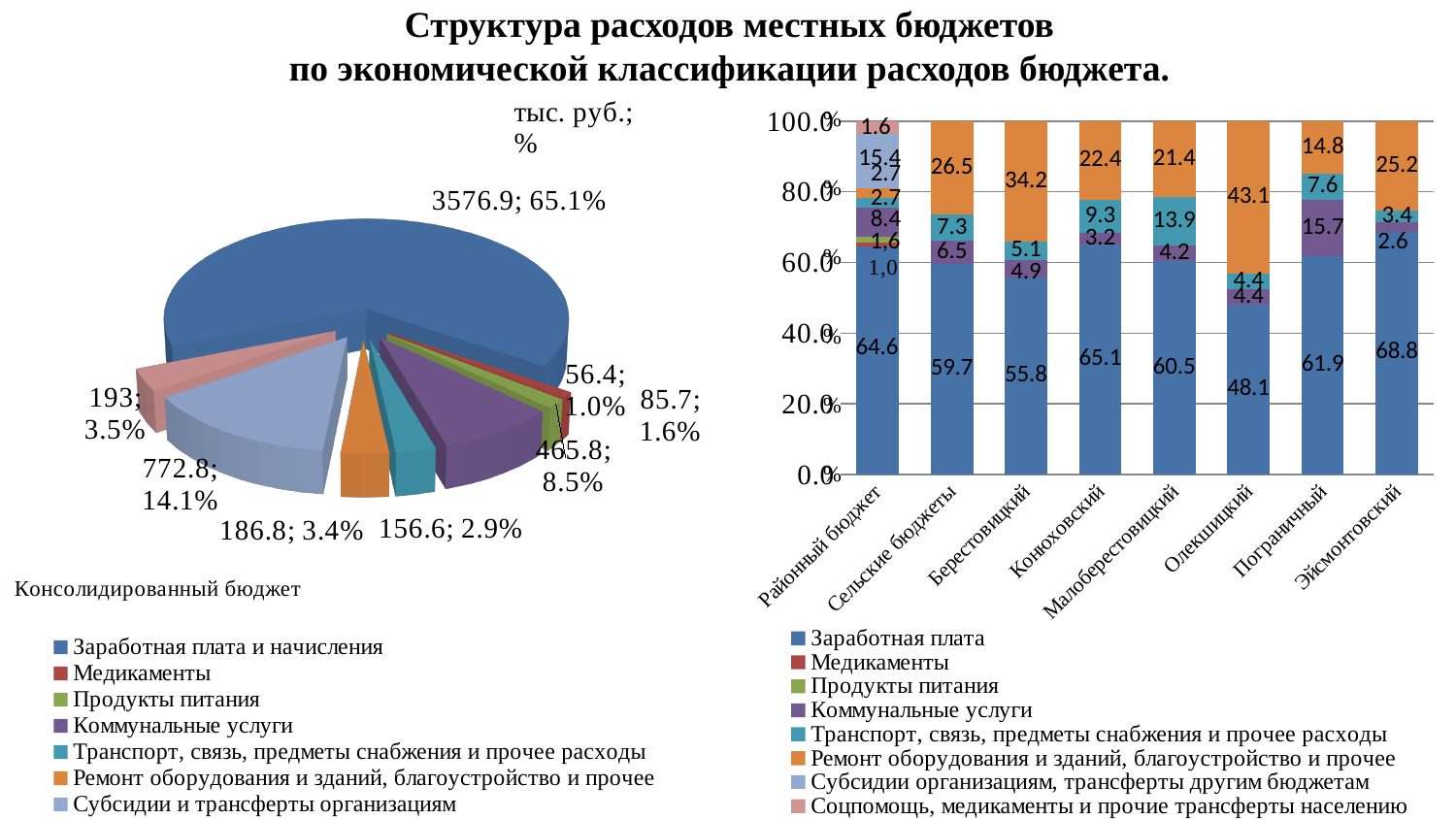
In the pie chart on the left, which category has the largest slice? Заработная плата и начисления In the bar chart on the right, what is the value of Заработная плата for Олекшицкий? 48.1 In the bar chart on the right, which category has the highest value for Заработная плата? Эйсмонтовский In the bar chart on the right, what is the value of Ремонт оборудования и зданий, благоустройство и прочее for Берестовицкий? 34.2 What kind of chart is the chart on the left of the slide (Консолидированный бюджет)? pie chart In the bar chart on the right, how many series does the legend list? 8 In the pie chart on the left, what value is shown for Субсидии и трансферты организациям? 772.8 In the pie chart on the left, what share of the total is Коммунальные услуги? 8.5% In the bar chart on the right, what is the difference between the Заработная плата values for Эйсмонтовский and Олекшицкий? 20.7 In the bar chart on the right, how many categories are shown on the x axis? 8 In the pie chart on the left, what value and share are shown for Заработная плата и начисления? 3576.9; 65.1% What kind of chart is the chart on the right of the slide? bar chart